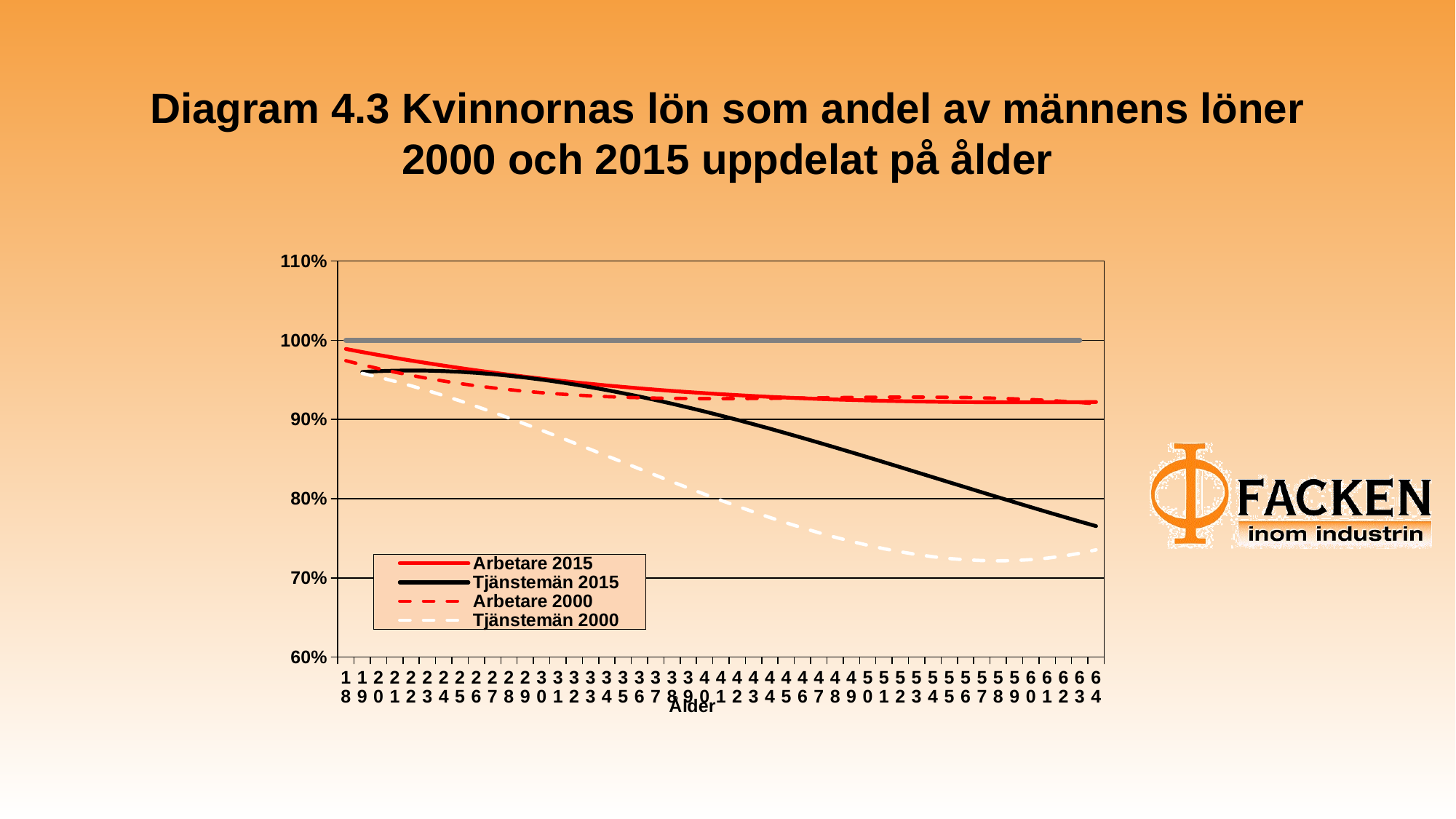
How many series does the legend list? 4 Is the value for Arbetare 2015 at age 64 greater or less than 90%? greater Which series has the highest value at age 18? Arbetare 2015 At age 64, which is larger: Arbetare 2015 or Tjänstemän 2015? Arbetare 2015 What is the title of the chart? Diagram 4.3 Kvinnornas lön som andel av männens löner 2000 och 2015 uppdelat på ålder Is the value for Tjänstemän 2015 at age 64 greater or less than 80%? less What is the label of the x axis? Ålder Is the value for Arbetare 2015 at age 18 greater or less than 90%? greater Which series has the lowest value at age 64? Tjänstemän 2000 Do the values for Tjänstemän 2015 rise or fall as age increases along the x axis? fall What kind of chart is shown on the slide? Line chart